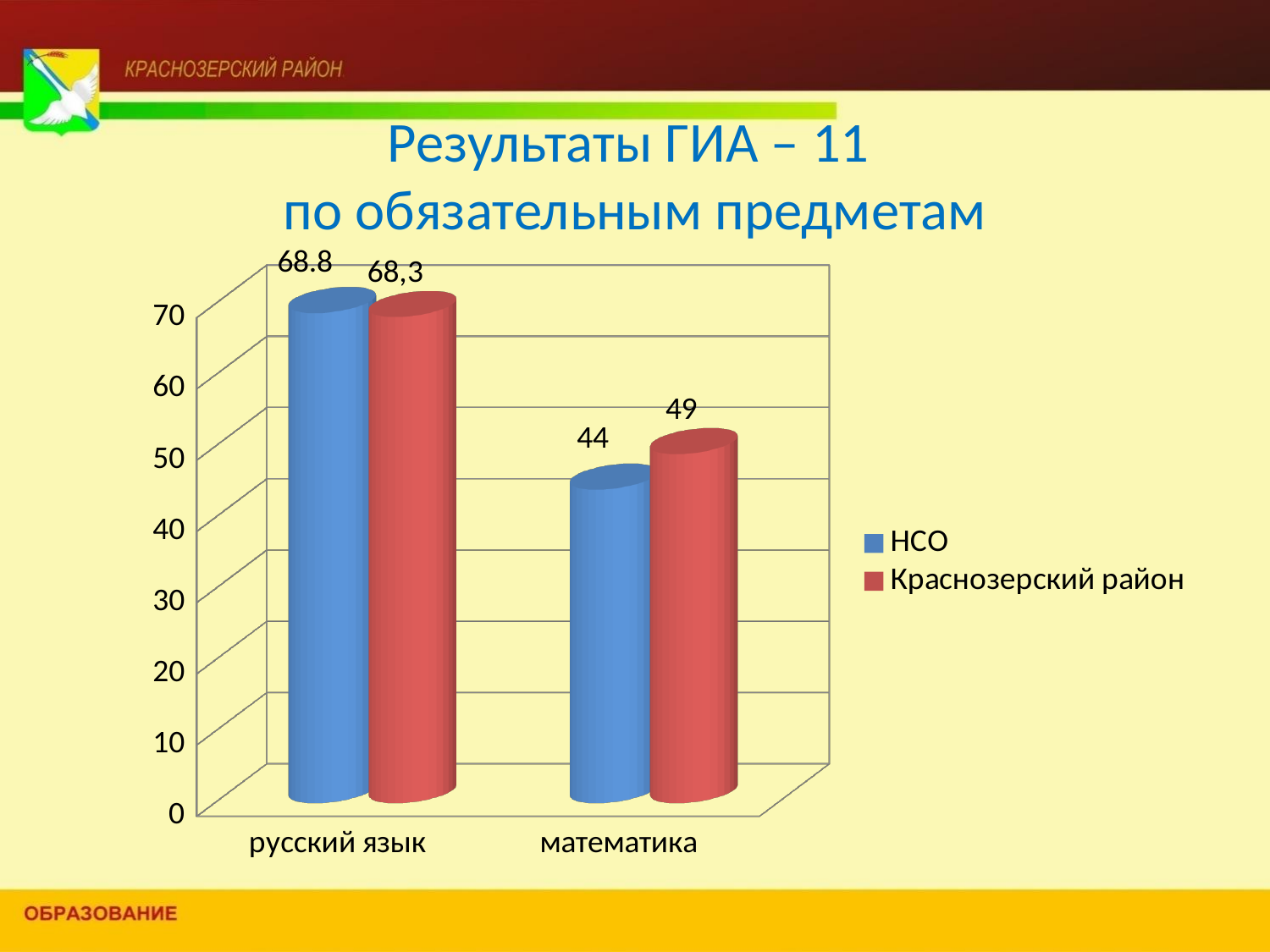
Which is larger: the value for Краснозерский район in математика or the value for НСО in математика? Краснозерский район in математика Which series has the higher value in русский язык? НСО What is the value for Краснозерский район in русский язык? 68,3 Which series has the lower value in математика? НСО Is the value for НСО in математика greater or less than 50? less What is the value for Краснозерский район in математика? 49 What kind of chart is shown on the slide? bar chart How many categories are shown on the x axis? 2 What is the value for НСО in русский язык? 68.8 What is the value for НСО in математика? 44 What is the difference between Краснозерский район and НСО in математика? 5 How many series does the legend list? 2